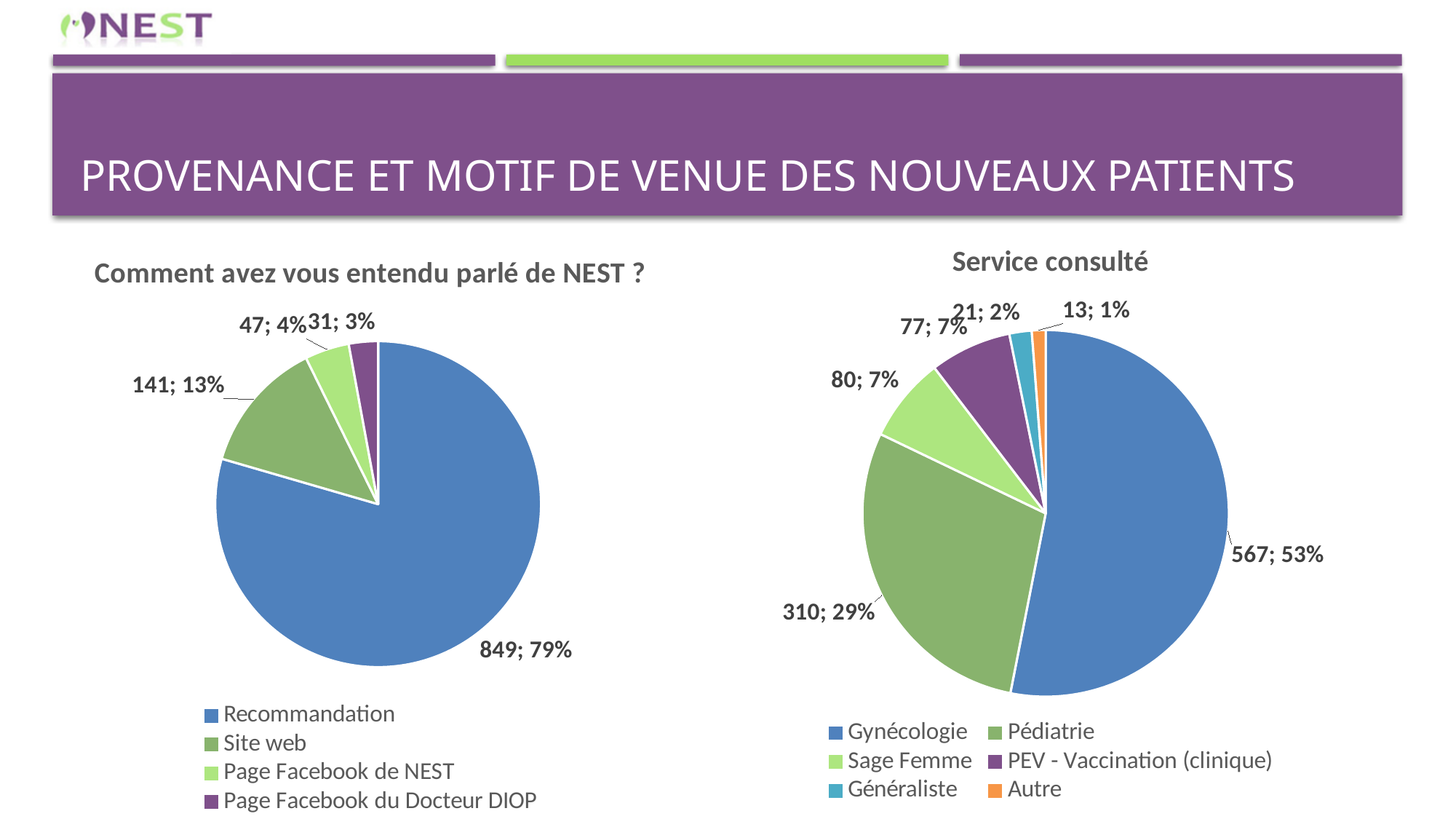
In the 'Service consulté' chart, which has a larger count: Sage Femme or Généraliste? Sage Femme In the 'Service consulté' chart, which service has the largest slice? Gynécologie In the 'Comment avez vous entendu parlé de NEST ?' chart, what share of the pie does Site web represent? 13% In the 'Comment avez vous entendu parlé de NEST ?' chart, what is the data label for the Recommandation slice? 849; 79% In the 'Comment avez vous entendu parlé de NEST ?' chart, which category has the smallest slice? Page Facebook du Docteur DIOP In the 'Service consulté' chart, how many categories does the legend list? 6 What type of chart is 'Service consulté'? Pie chart In the 'Service consulté' chart, which service has the smallest slice? Autre In the 'Service consulté' chart, what share of the pie does Gynécologie represent? 53% In the 'Comment avez vous entendu parlé de NEST ?' chart, how many categories does the legend list? 4 In the 'Comment avez vous entendu parlé de NEST ?' chart, what is the difference between the counts for Site web and Page Facebook de NEST? 94 In the 'Service consulté' chart, what is the data label for the Pédiatrie slice? 310; 29%